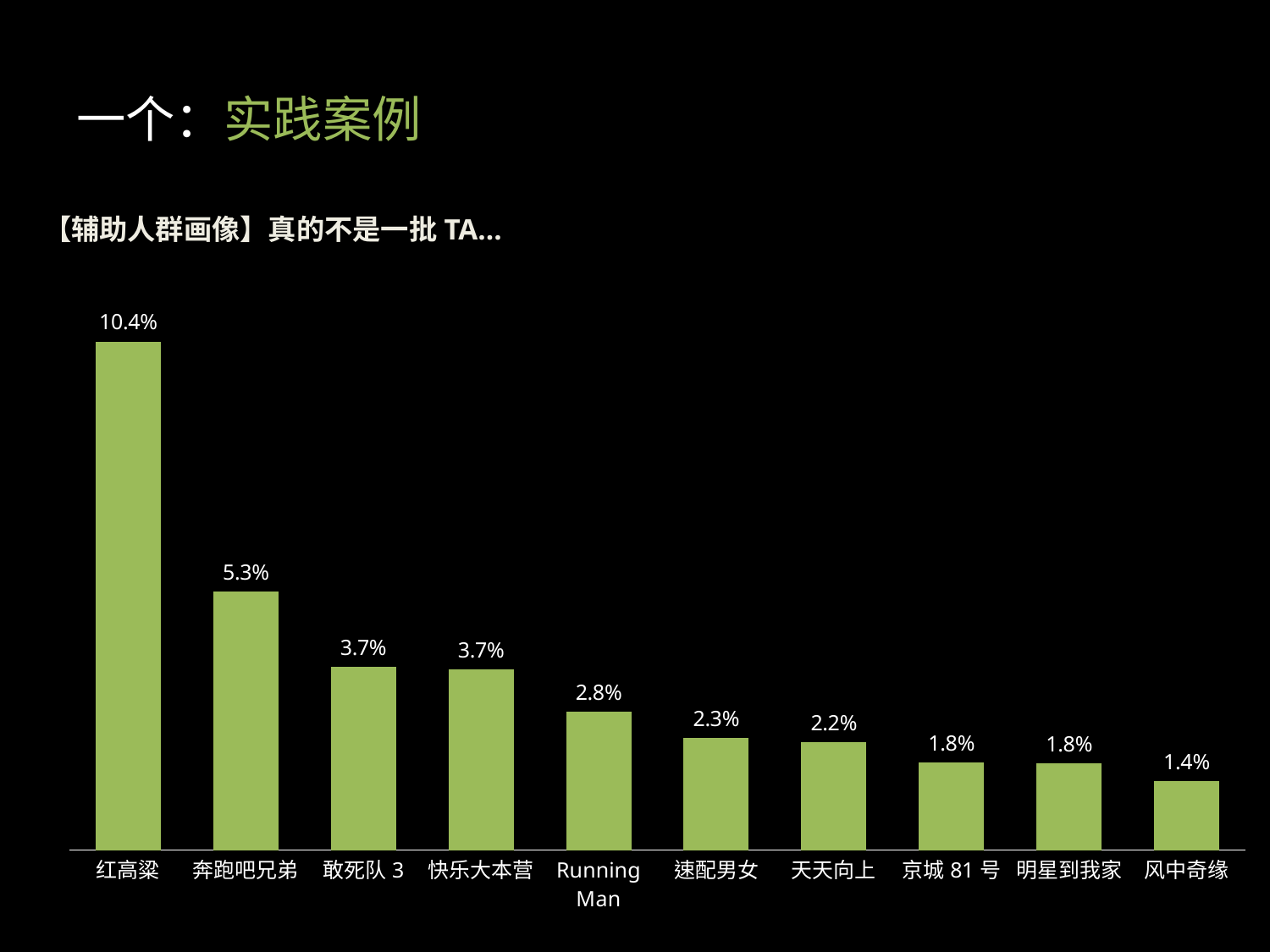
What is the difference between the values for 速配男女 and 风中奇缘? 0.9% Which is larger, the value for 敢死队 3 or the value for 天天向上? 敢死队 3 What is the value for 奔跑吧兄弟? 5.3% What is the value for 风中奇缘? 1.4% What is the value for Running Man? 2.8% What is the difference between the values for 红高粱 and 奔跑吧兄弟? 5.1% Do the values rise or fall from left to right along the x axis? fall What is the value for 红高粱? 10.4% How many categories are shown in the chart? 10 Which category has the lowest value? 风中奇缘 Which category has the highest value? 红高粱 What kind of chart is shown on the slide? bar chart